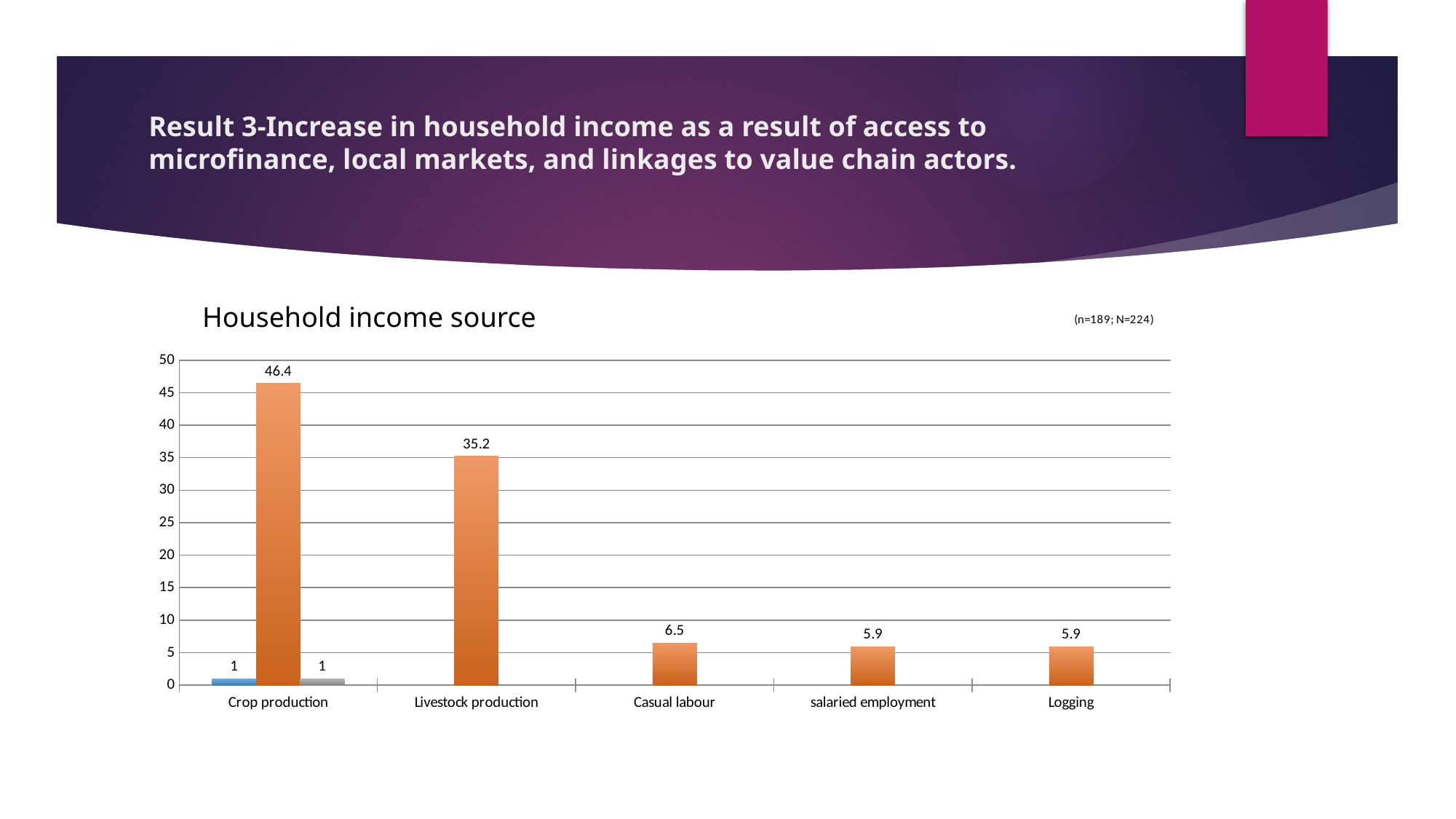
Is the value for Livestock production greater or less than 30? greater What type of chart is shown on the slide? bar chart Which is larger, the value for Casual labour or the value for salaried employment? Casual labour What sample size note is printed at the top right of the chart? (n=189; N=224) What is the difference between the orange bar for Crop production and the bar for Livestock production? 11.2 What is the value for Logging? 5.9 What is the value of the orange bar for Crop production? 46.4 What is the value for Casual labour? 6.5 How many income source categories are shown on the x axis? 5 What is the value for Livestock production? 35.2 Which income source has the highest orange bar? Crop production What is the title of the chart? Household income source